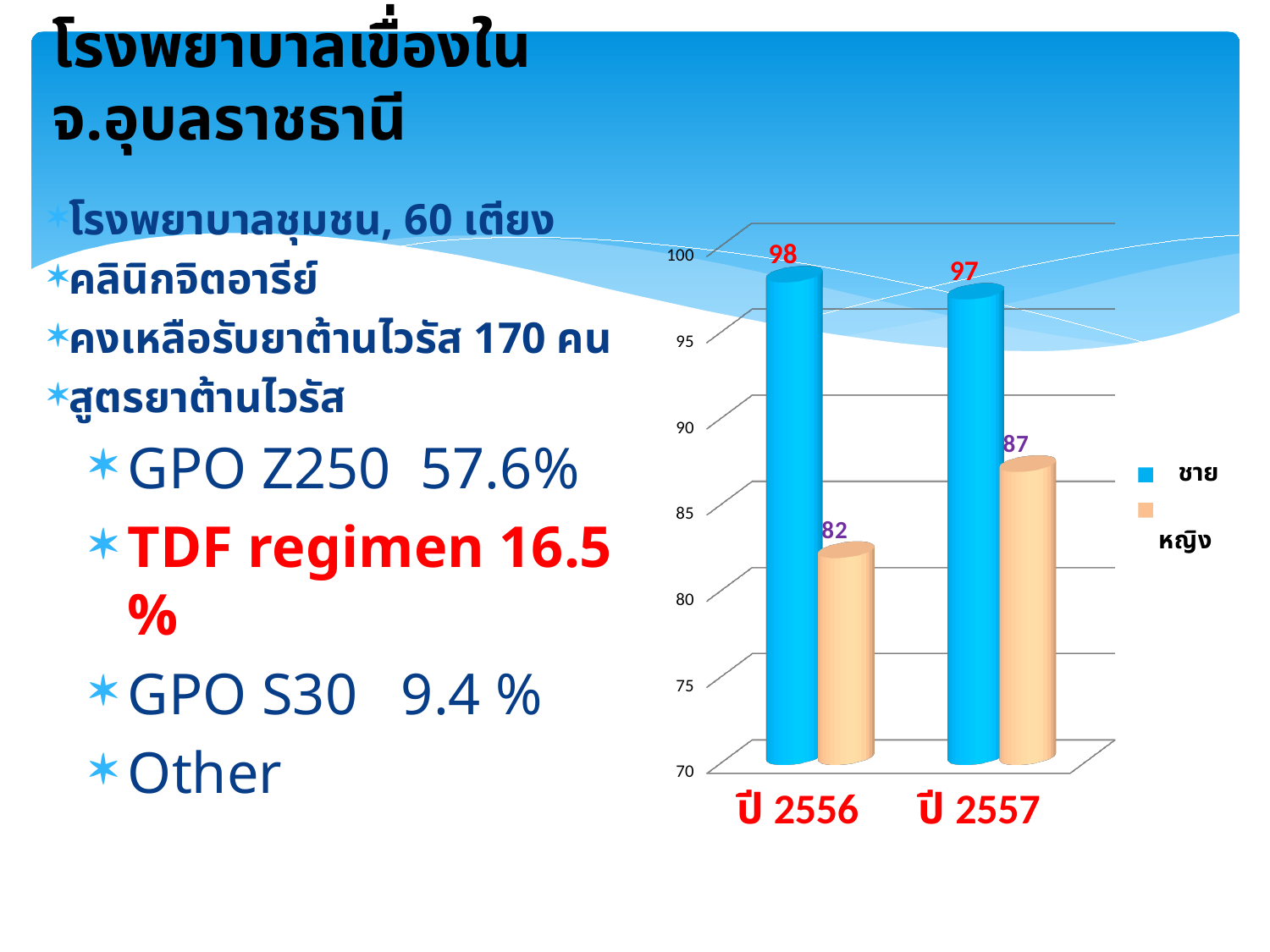
What is the value for ชาย in ปี 2556? 98 Does the หญิง value rise or fall from ปี 2556 to ปี 2557? rise What kind of chart is shown on the slide? bar chart What is the difference between the หญิง values for ปี 2557 and ปี 2556? 5 Which is larger, the ชาย value in ปี 2556 or the ชาย value in ปี 2557? ปี 2556 What is the value for ชาย in ปี 2557? 97 What is the value for หญิง in ปี 2556? 82 What is the difference between ชาย and หญิง in ปี 2556? 16 What is the value for หญิง in ปี 2557? 87 Which series has the lowest value in ปี 2556? หญิง How many series does the legend list? 2 How many categories are shown on the x axis? 2